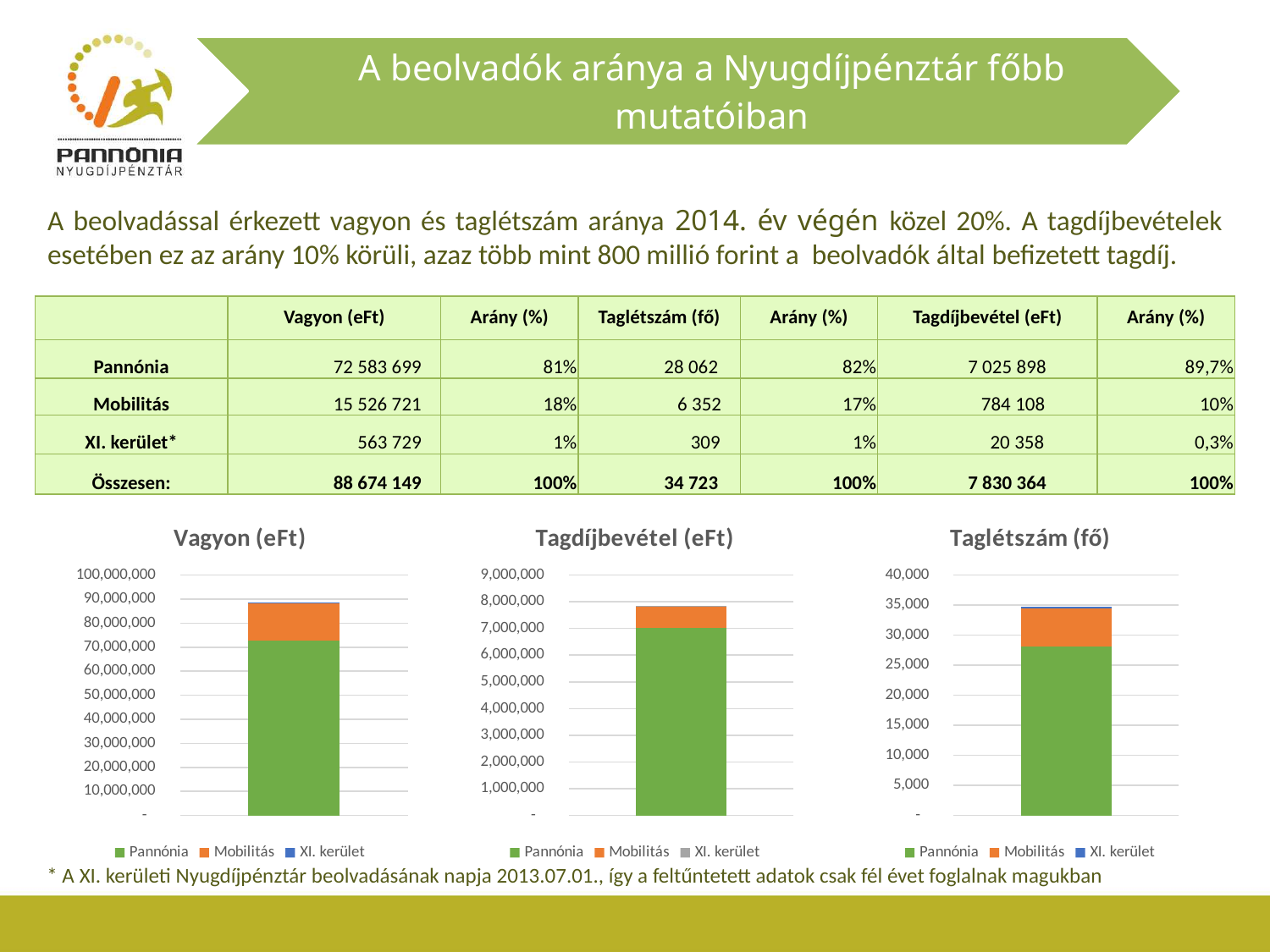
What is the title of the rightmost chart on the slide? Taglétszám (fő) In the Vagyon (eFt) chart, is the top of the stacked bar greater or less than 80,000,000? greater In the Taglétszám (fő) chart, is the top of the stacked bar greater or less than 30,000? greater What colour represents Mobilitás in the legend of the Vagyon (eFt) chart? orange How many stacked bars are plotted in the Tagdíjbevétel (eFt) chart? 1 In the Tagdíjbevétel (eFt) chart, is the Pannónia segment greater or less than 6,000,000? greater In the Taglétszám (fő) chart, which segment is larger, Mobilitás or XI. kerület? Mobilitás What kind of chart is the Vagyon (eFt) chart? bar chart How many series does the legend of the Vagyon (eFt) chart list? 3 In the Vagyon (eFt) chart, which segment is larger, Pannónia or Mobilitás? Pannónia